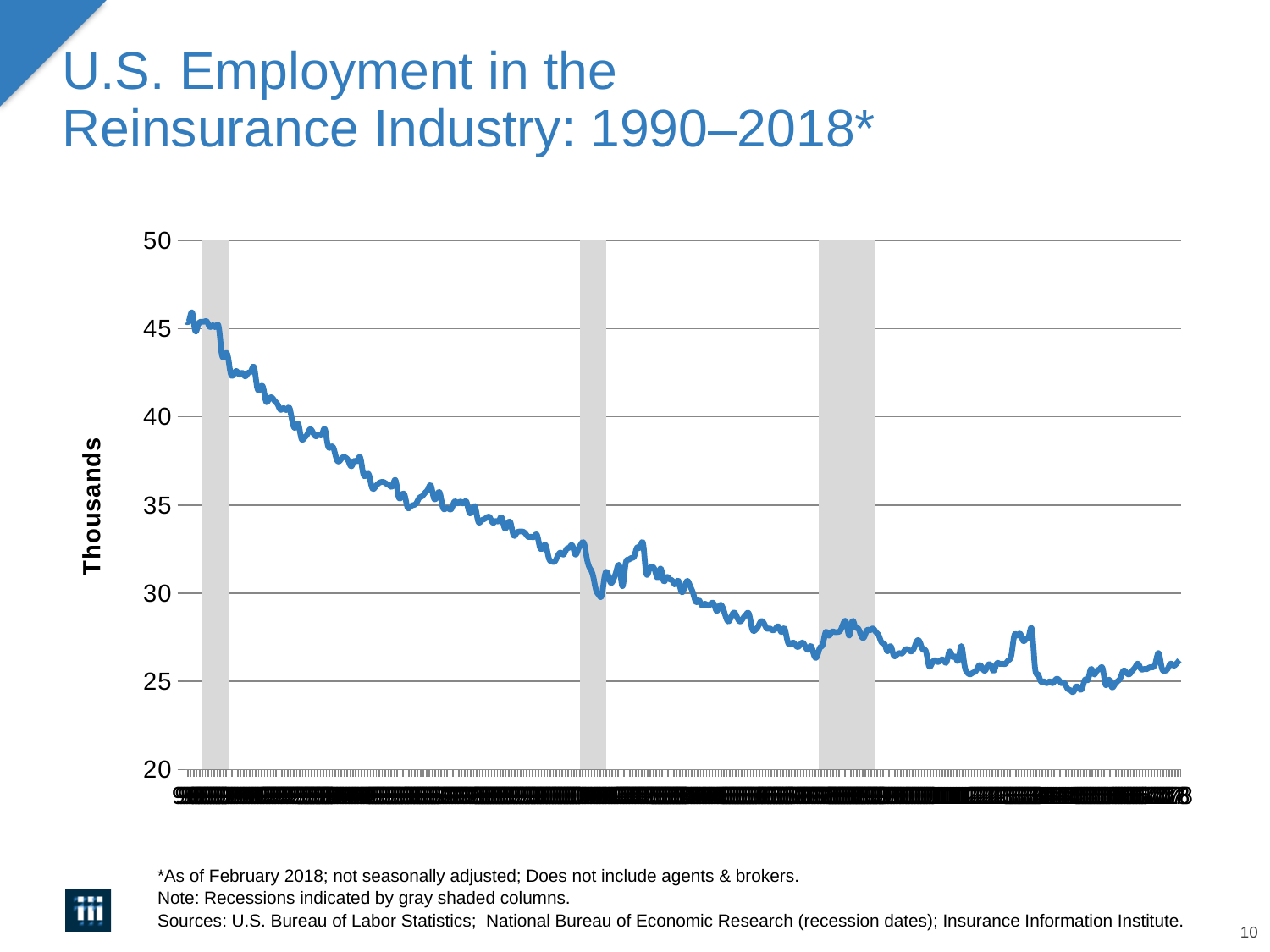
Is the highest value on the line greater or less than 40? greater What kind of chart is shown on the slide? line chart What label is shown on the vertical axis? Thousands Is the value at the start of the series (1990) greater or less than 40? greater Overall, do the values rise or fall from the left of the x axis to the right? fall What is the title of the chart? U.S. Employment in the Reinsurance Industry: 1990–2018* Is the value at the end of the series (2018) greater or less than 30? less